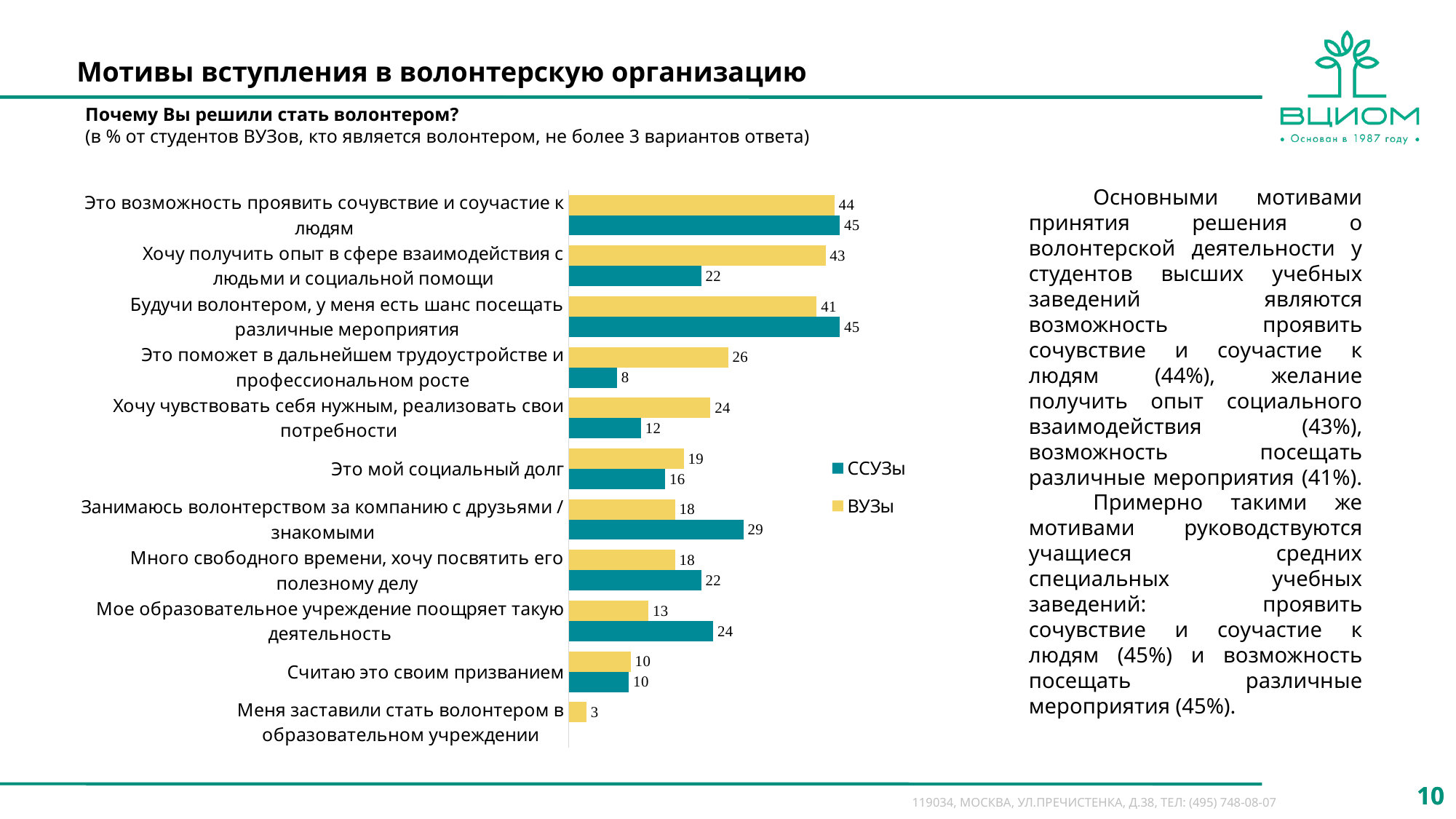
What is the value for ССУЗы for "Занимаюсь волонтерством за компанию с друзьями / знакомыми"? 29 What is the difference between the ВУЗы and ССУЗы values for "Хочу получить опыт в сфере взаимодействия с людьми и социальной помощи"? 21 Which category has the lowest value for ВУЗы? Меня заставили стать волонтером в образовательном учреждении What type of chart is shown on the slide? bar chart What is the difference between the ССУЗы and ВУЗы values for "Это поможет в дальнейшем трудоустройстве и профессиональном росте"? 18 How many series does the legend list? 2 What is the value for ВУЗы for "Хочу получить опыт в сфере взаимодействия с людьми и социальной помощи"? 43 What is the value for ССУЗы for "Это поможет в дальнейшем трудоустройстве и профессиональном росте"? 8 For "Мое образовательное учреждение поощряет такую деятельность", which series has the larger value, ВУЗы or ССУЗы? ССУЗы Which category has the highest value for ВУЗы? Это возможность проявить сочувствие и соучастие к людям How many categories (answer options) are shown on the chart? 11 Which colour represents the ВУЗы series in the chart? yellow